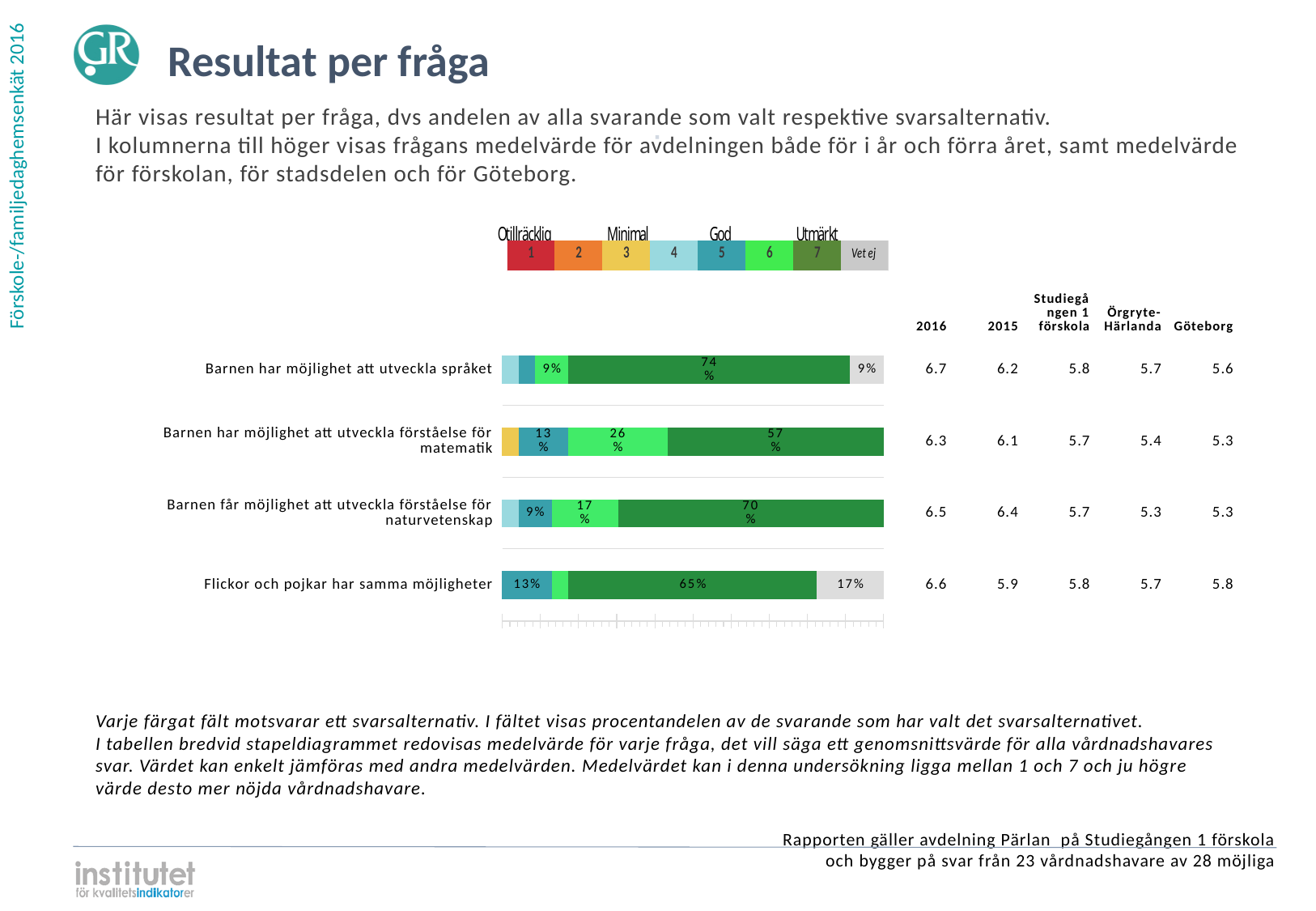
Which has a larger 'Utmärkt' (7) share: 'Barnen har möjlighet att utveckla språket' or 'Flickor och pojkar har samma möjligheter'? Barnen har möjlighet att utveckla språket What percentage of respondents chose 'Utmärkt' (7) for 'Barnen har möjlighet att utveckla språket'? 74% What is the difference in percentage points between the 'Utmärkt' (7) share for 'Barnen har möjlighet att utveckla språket' and for 'Flickor och pojkar har samma möjligheter'? 9 percentage points What percentage chose answer 6 for 'Barnen har möjlighet att utveckla förståelse för matematik'? 26% How many questions (bars) are shown in the chart? 4 What percentage chose 'Utmärkt' (7) for 'Barnen får möjlighet att utveckla förståelse för naturvetenskap'? 70% How many answer categories does the legend list? 8 Which question has the highest share of 'Utmärkt' (7) responses? Barnen har möjlighet att utveckla språket What percentage chose 'Utmärkt' (7) for 'Barnen har möjlighet att utveckla förståelse för matematik'? 57% Which question has the lowest share of 'Utmärkt' (7) responses? Barnen har möjlighet att utveckla förståelse för matematik What type of chart is shown on the slide? Stacked bar chart What percentage chose 'Vet ej' for 'Flickor och pojkar har samma möjligheter'? 17%